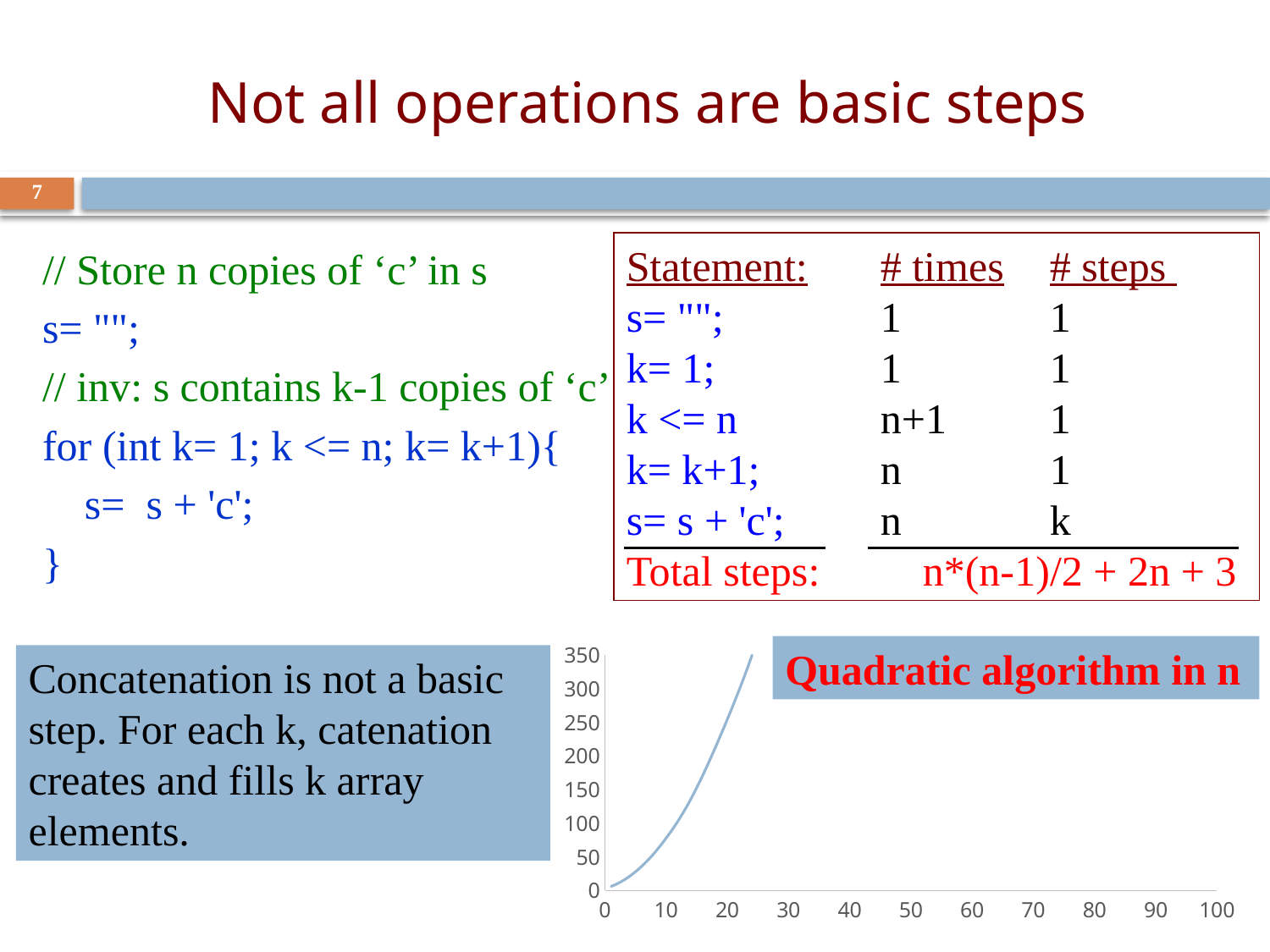
Does the plotted line rise or fall as the x-axis value increases? rise Is the value of the plotted line at x = 10 greater or less than 100? less Is the value of the plotted line at x = 20 greater or less than 300? less How many lines are plotted on the chart? 1 What kind of chart is shown at the bottom of the slide? line chart Is the value of the plotted line at x = 20 greater or less than 150? greater What is the highest value labelled on the chart's x-axis? 100 What is the highest value labelled on the chart's y-axis? 350